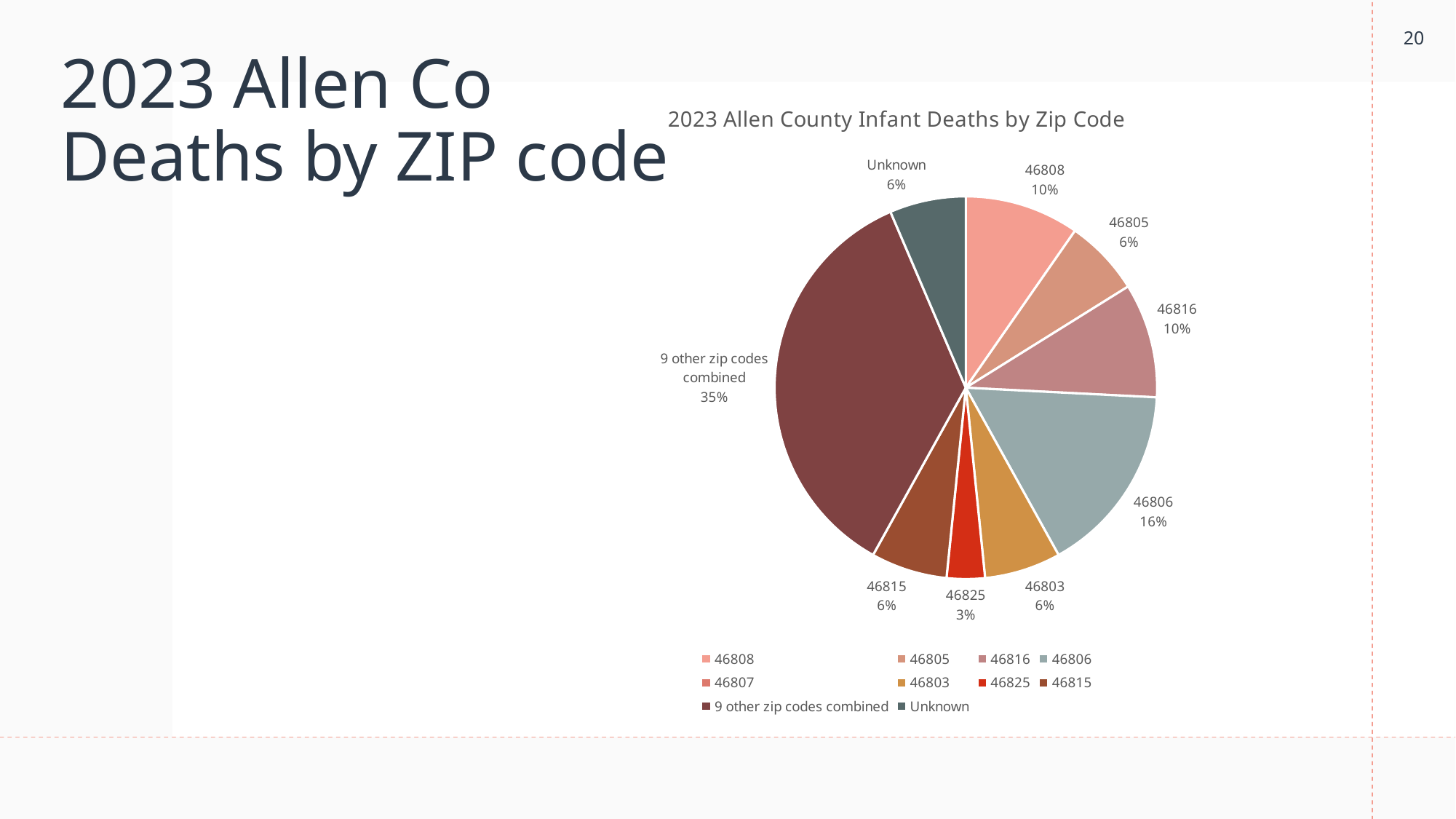
What is the difference in percentage points between zip code 46806 and zip code 46808? 6 What percentage is shown for zip code 46825? 3% Which category has the largest slice of the pie? 9 other zip codes combined What is the title of the chart? 2023 Allen County Infant Deaths by Zip Code Which labeled zip code has the smallest slice of the pie? 46825 What percentage is shown for zip code 46803? 6% What kind of chart is shown on the slide? pie chart Which has a larger share, zip code 46816 or zip code 46815? 46816 What share of infant deaths is attributed to zip code 46806? 16% What percentage is shown for the Unknown category? 6% What share of infant deaths is attributed to the 9 other zip codes combined? 35% How many entries does the legend list? 10